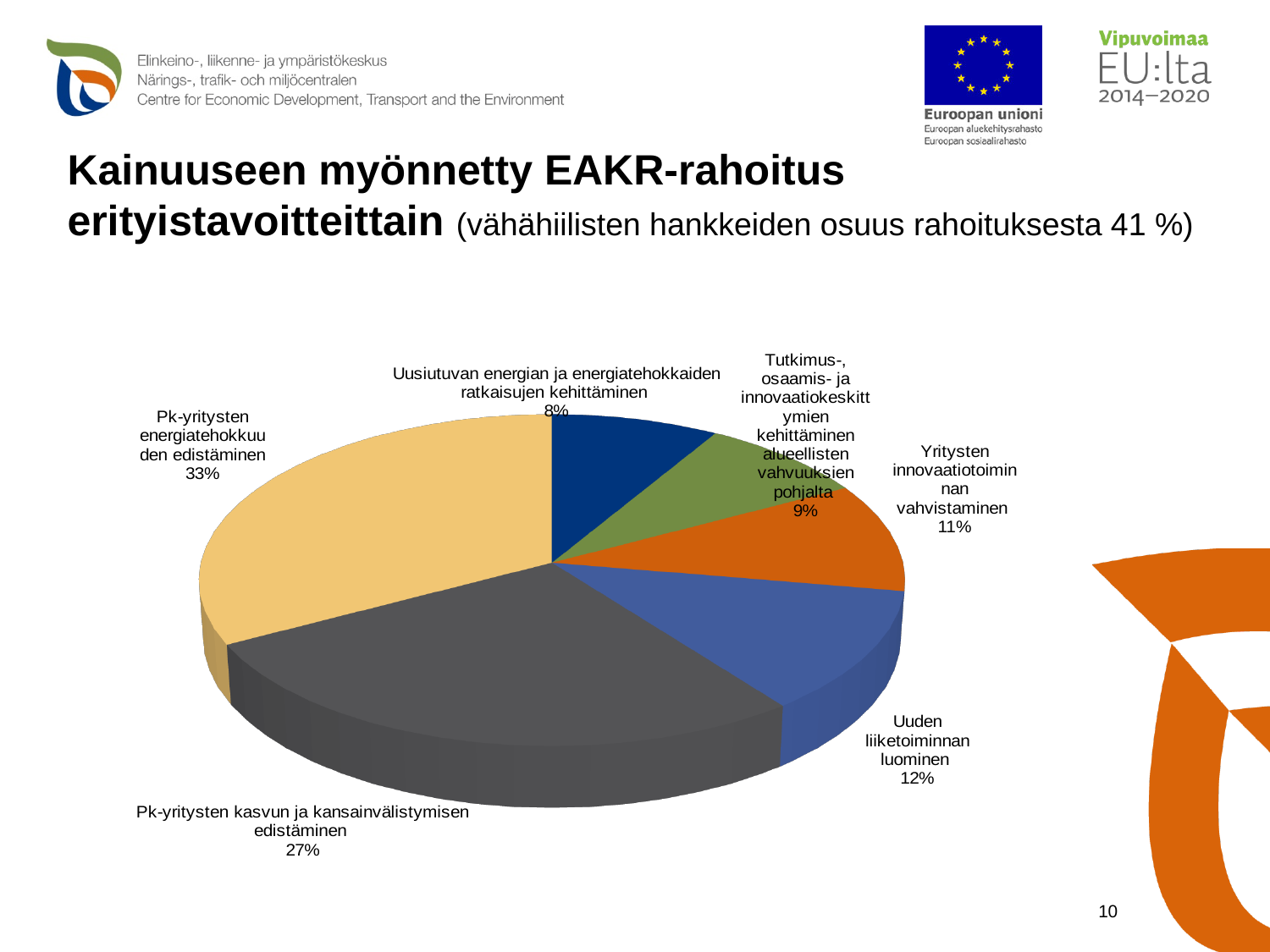
Which category has the smallest share of the pie? Uusiutuvan energian ja energiatehokkaiden ratkaisujen kehittäminen What kind of chart is shown on the slide? Pie chart According to the slide title, what is the share of low-carbon projects (vähähiiliset hankkeet) in the funding? 41 % What share of the pie is 'Uusiutuvan energian ja energiatehokkaiden ratkaisujen kehittäminen'? 8% What share of the pie is 'Yritysten innovaatiotoiminnan vahvistaminen'? 11% What is the difference in percentage points between 'Pk-yritysten energiatehokkuuden edistäminen' and 'Pk-yritysten kasvun ja kansainvälistymisen edistäminen'? 6 percentage points What share of the pie is 'Uuden liiketoiminnan luominen'? 12% Which is larger: the share for 'Uuden liiketoiminnan luominen' or the share for 'Yritysten innovaatiotoiminnan vahvistaminen'? Uuden liiketoiminnan luominen How many slices does the pie chart have? 6 Which category has the largest share of the pie? Pk-yritysten energiatehokkuuden edistäminen